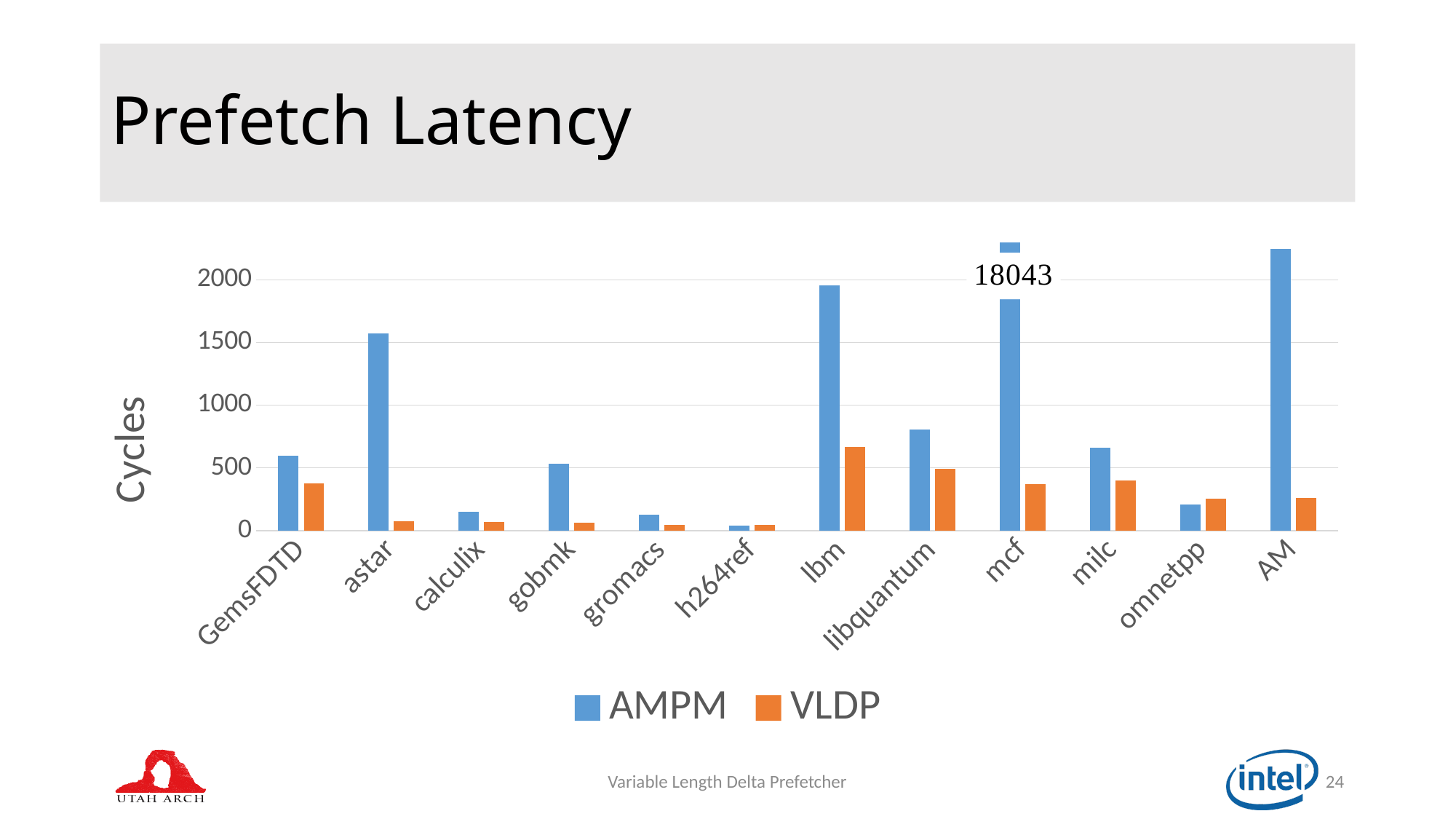
How many benchmark categories are shown on the x axis? 12 What kind of chart is shown on the slide? bar chart What is the label on the y axis? Cycles Is the AMPM value for lbm greater or less than 1500? greater What colour represents the VLDP series? orange Which category has the highest AMPM value? mcf Which category has the lowest AMPM value? h264ref Is the AMPM value for AM greater or less than 2000? greater For libquantum, which series has the larger value, AMPM or VLDP? AMPM How many series does the legend list? 2 What is the AMPM prefetch latency value printed for mcf? 18043 Is the VLDP value for GemsFDTD greater or less than 500? less